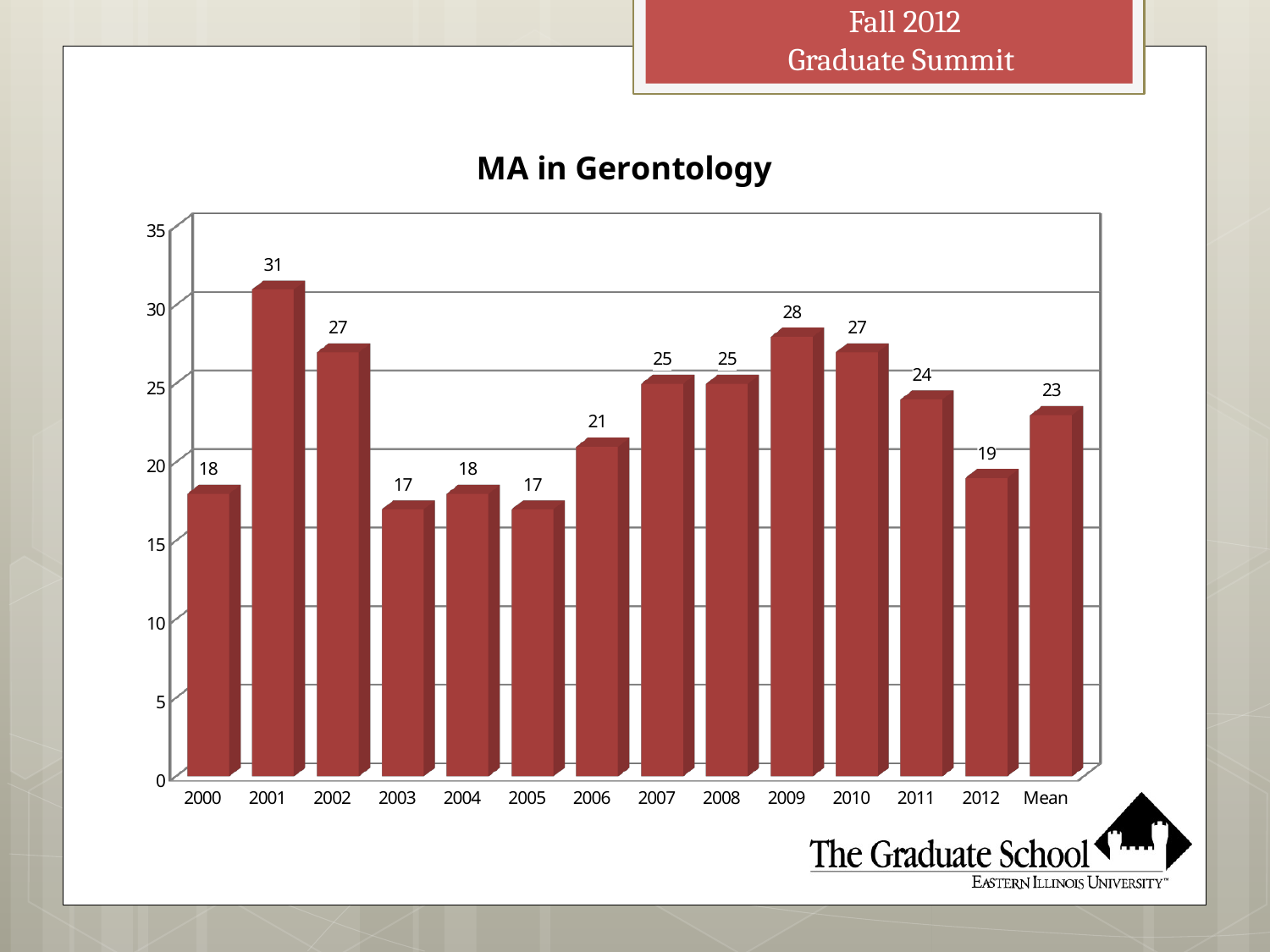
What is the value for 2001? 31 What is the lowest value shown on the chart? 17 What kind of chart is this? bar chart Which is larger, the value for 2002 or the value for 2011? 2002 What is the value shown for Mean? 23 What is the value for 2009? 28 What is the title of the chart? MA in Gerontology Do the values rise or fall from 2005 to 2009? rise What is the difference between the values for 2001 and 2012? 12 How many categories are shown on the x axis? 14 Which category has the highest value? 2001 Is the value for 2006 greater or less than 20? greater